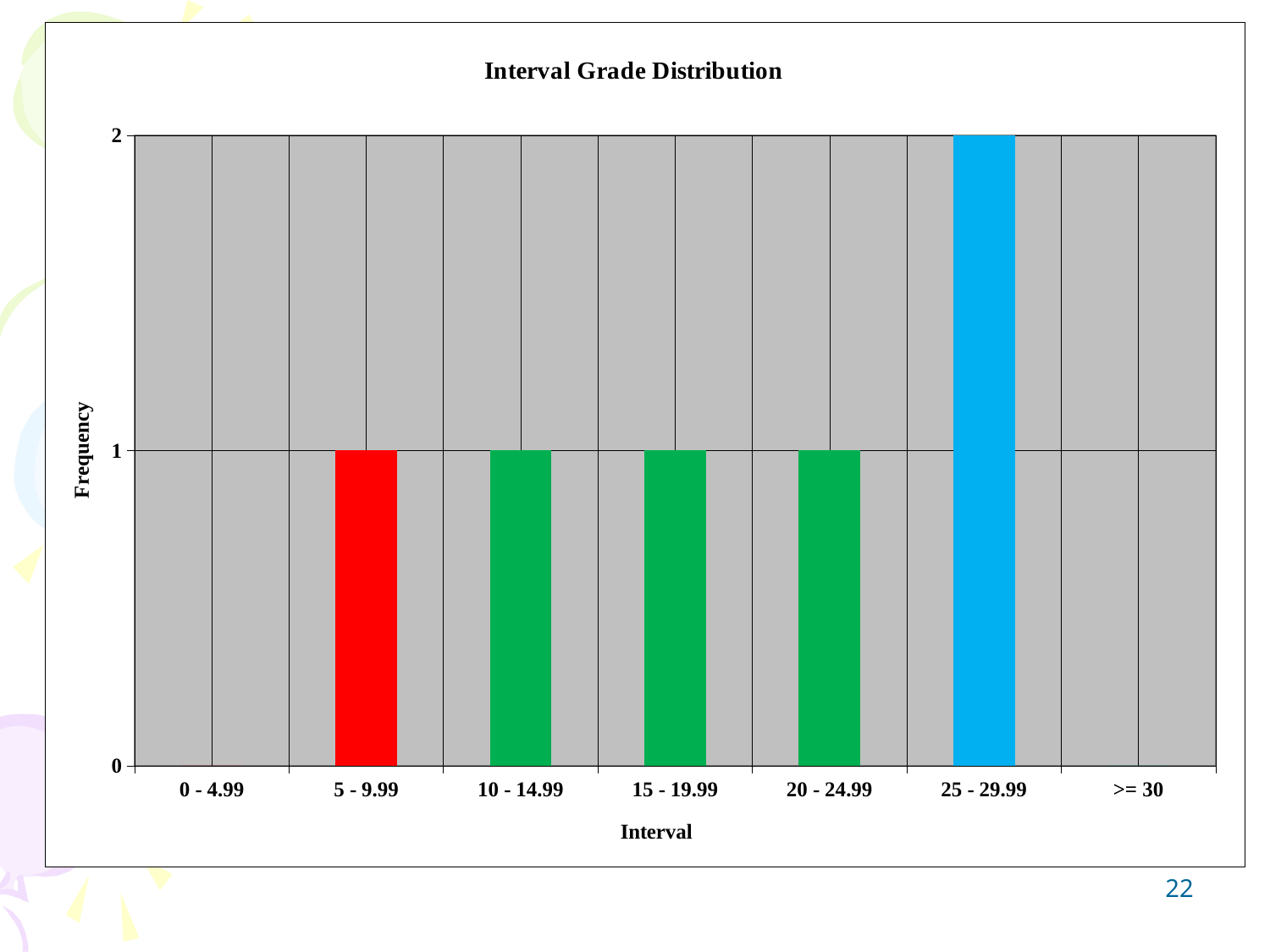
Which interval has the highest frequency? 25 - 29.99 What is the label of the y axis of the chart? Frequency What is the frequency for the interval 0 - 4.99? 0 How many intervals are shown on the x axis of the chart? 7 What is the frequency for the interval 25 - 29.99? 2 What kind of chart is shown on the slide? bar chart What is the frequency for the interval 5 - 9.99? 1 What is the title of the chart? Interval Grade Distribution Which has the larger frequency, the interval 25 - 29.99 or the interval 20 - 24.99? 25 - 29.99 What is the difference in frequency between the interval 25 - 29.99 and the interval 15 - 19.99? 1 What is the frequency for the interval >= 30? 0 How many intervals have a frequency of 1? 4